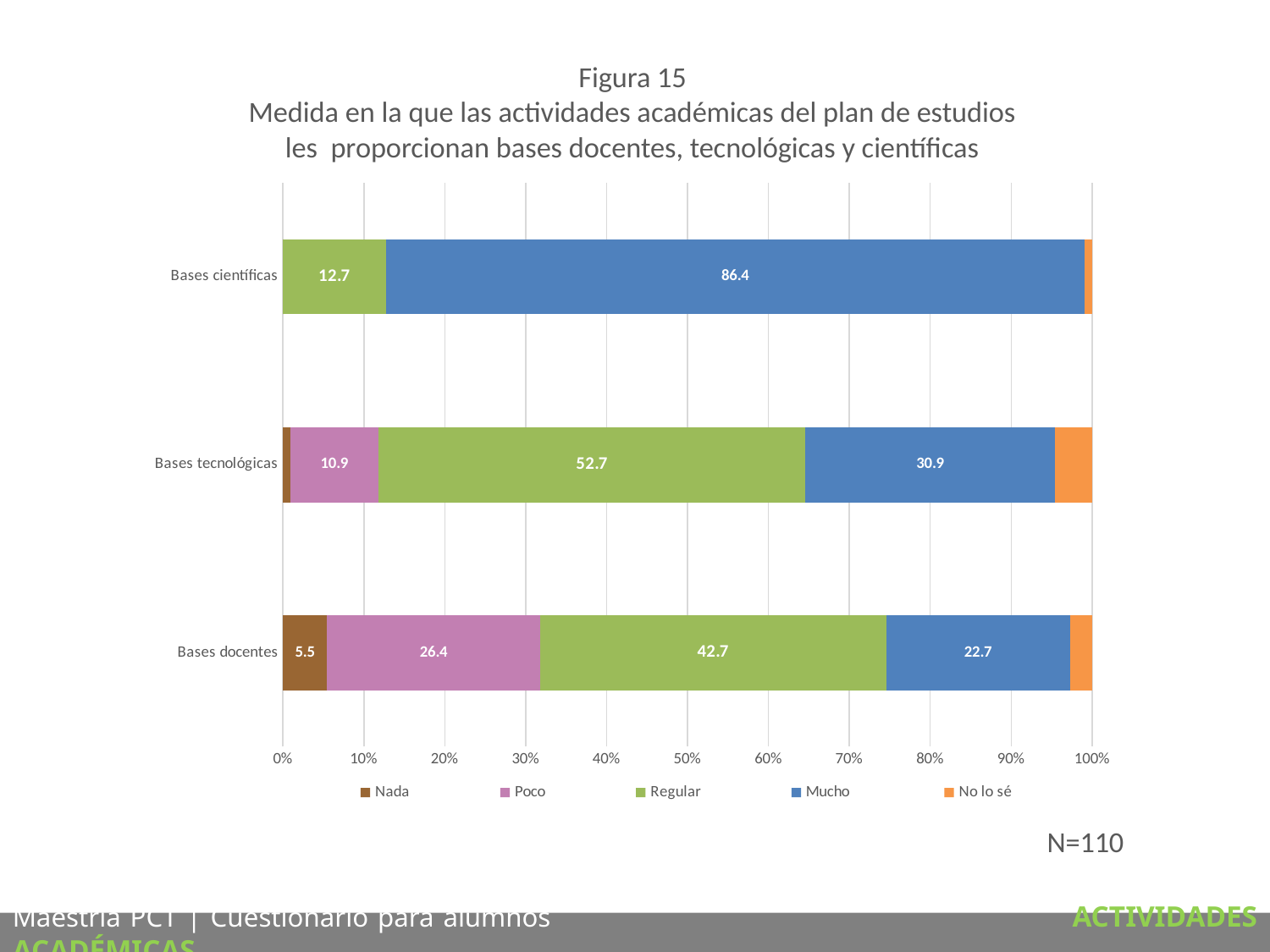
What is the value of the Regular segment for Bases tecnológicas? 52.7 Which is larger, the Mucho value for Bases tecnológicas or the Mucho value for Bases docentes? Bases tecnológicas Which category has the lowest Mucho value? Bases docentes Which category has the highest Mucho value? Bases científicas How many categories are plotted on the vertical axis? 3 What is the value of the Poco segment for Bases docentes? 26.4 Which series is shown in orange in the legend? No lo sé What is the difference between the Regular values for Bases tecnológicas and Bases docentes? 10 What kind of chart is shown on the slide? Stacked bar chart How many series does the legend list? 5 What is the value of the Mucho segment for Bases científicas? 86.4 What is the value of the Nada segment for Bases docentes? 5.5